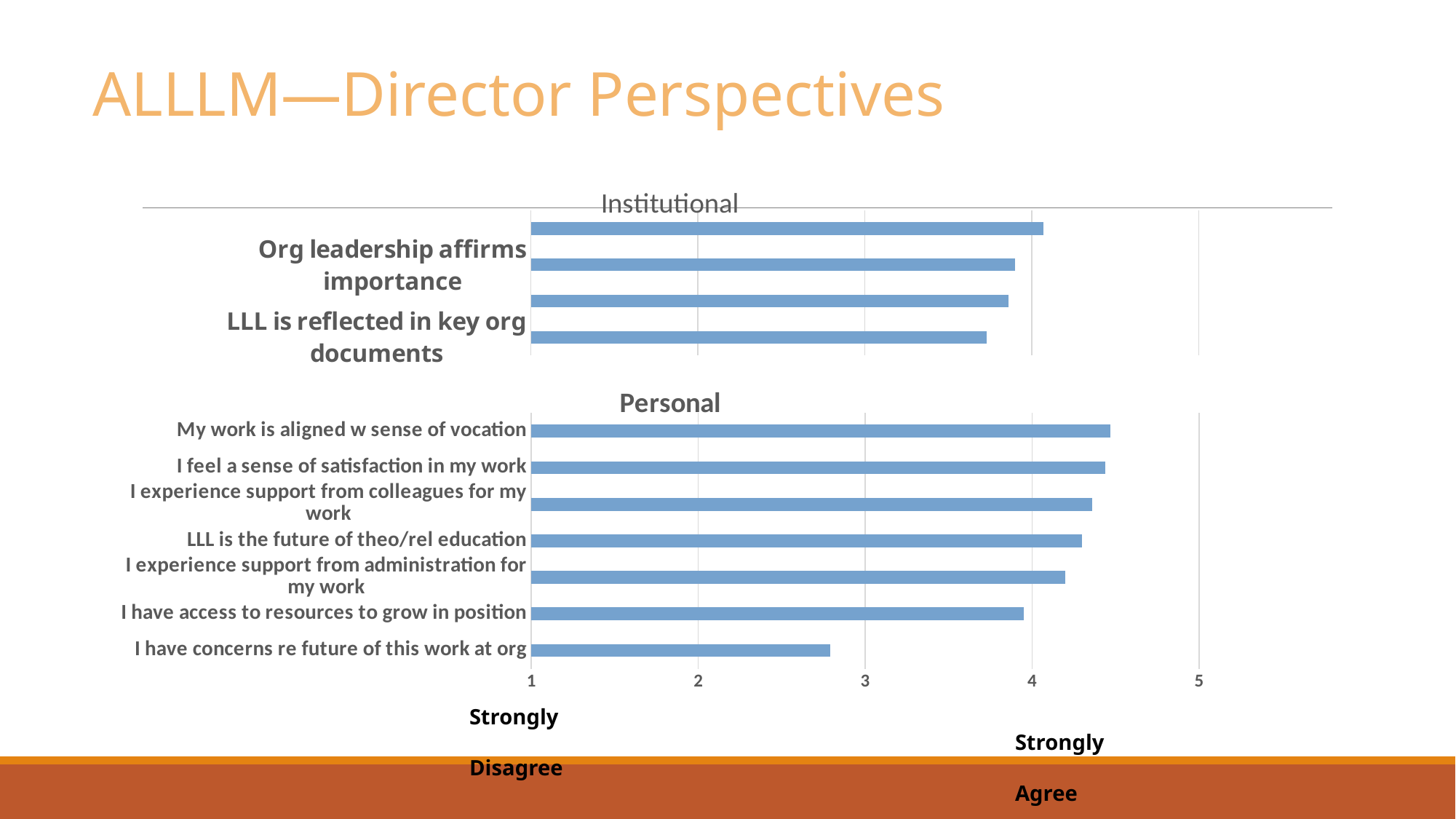
What is the title of the top chart on the slide? Institutional In the Personal chart, is the value for 'I have concerns re future of this work at org' greater or less than 3? less In the Personal chart, which category has the lowest value? I have concerns re future of this work at org How many categories are plotted in the Personal chart? 7 What kind of chart is the Personal chart? bar chart In the Personal chart, do the bar values increase or decrease from top to bottom? decrease In the Personal chart, is the value for 'My work is aligned w sense of vocation' greater or less than 4? greater In the Personal chart, which is larger: 'LLL is the future of theo/rel education' or 'I have access to resources to grow in position'? LLL is the future of theo/rel education In the Personal chart, which is larger: 'I have access to resources to grow in position' or 'I have concerns re future of this work at org'? I have access to resources to grow in position In the Personal chart, is the value for 'I experience support from administration for my work' greater or less than 4? greater How many bars are plotted in the Institutional chart? 4